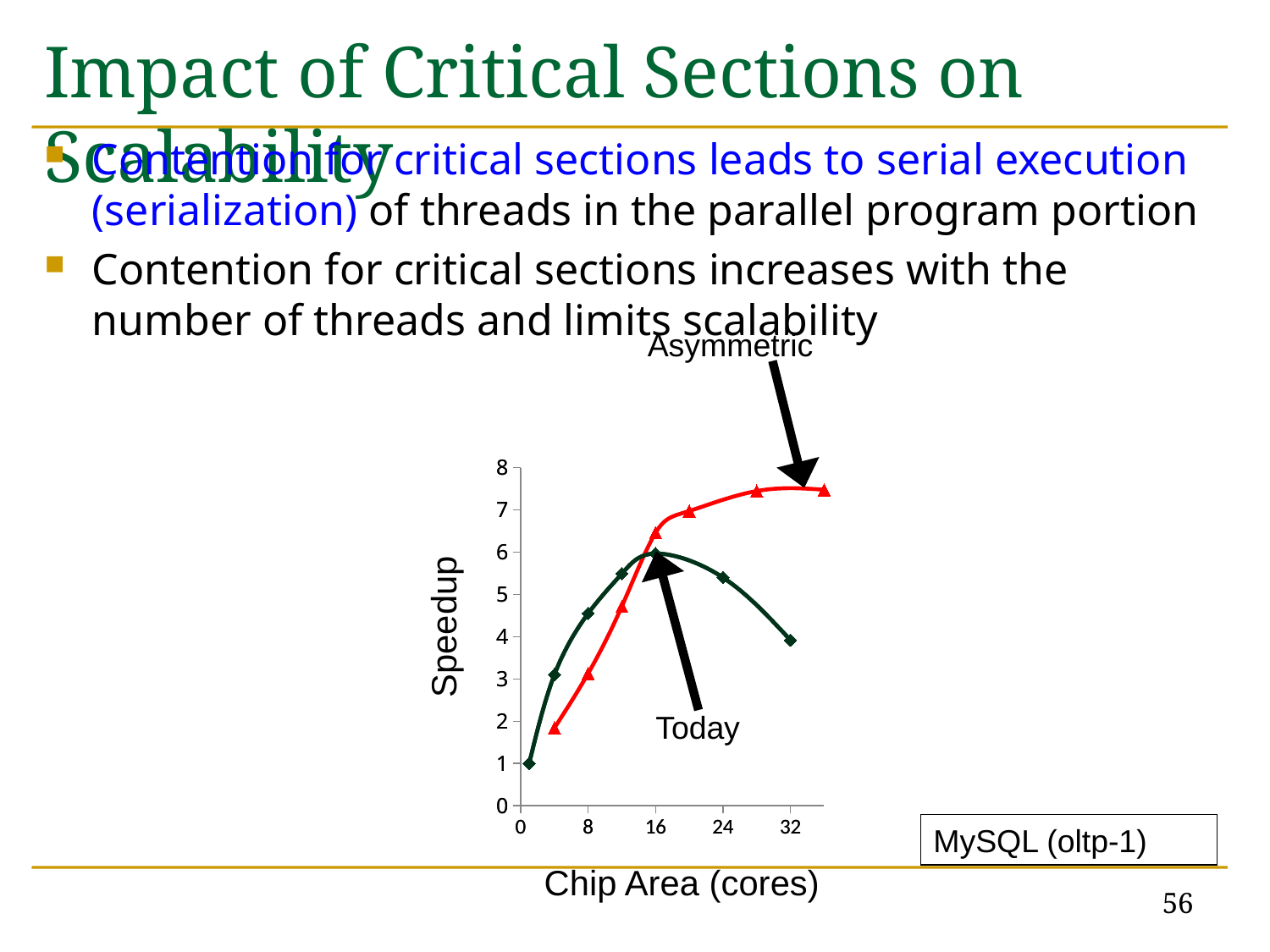
How many data points are plotted on the Today line? 7 What kind of chart is shown on the slide? line chart At 8 cores, which line has the higher speedup, Today or Asymmetric? Today At which chip area (cores) does the Today line reach its highest speedup? 16 What is the label of the y axis of the chart? Speedup How many lines are plotted in the chart? 2 At 24 cores, which line has the higher speedup, Today or Asymmetric? Asymmetric What is the label of the x axis of the chart? Chip Area (cores) Is the speedup of the Today line at 32 cores greater or less than 5? less Is the speedup of the Asymmetric line at its rightmost point greater or less than 7? greater Is the speedup of the Asymmetric line at 8 cores greater or less than 4? less Does the speedup of the Today line rise or fall between 16 and 32 cores? fall